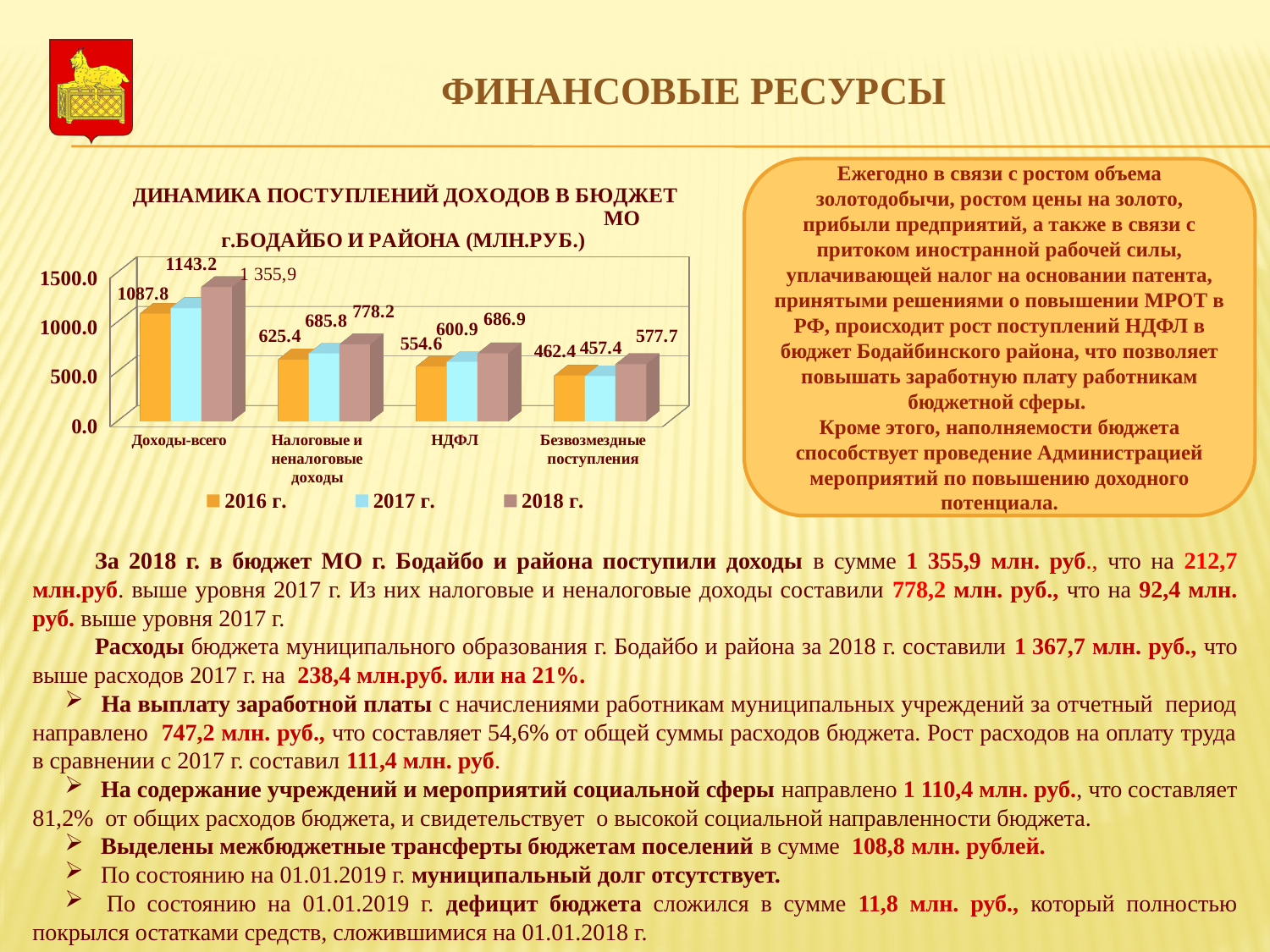
What is the difference between the 2018 г. and 2017 г. values for НДФЛ? 86.0 What kind of chart is shown on the slide? bar chart What is the value for 2018 г. in the Налоговые и неналоговые доходы category? 778.2 What is the value for 2017 г. in the Безвозмездные поступления category? 457.4 Which is larger for Безвозмездные поступления: the 2016 г. value or the 2017 г. value? 2016 г. Which category has the highest value for 2018 г.? Доходы-всего Is the 2017 г. value for Налоговые и неналоговые доходы greater or less than 500.0? greater How many categories are shown on the x axis of the chart? 4 Which category has the lowest value for 2016 г.? Безвозмездные поступления How many series does the chart legend list? 3 What is the value for 2018 г. in the Доходы-всего category? 1 355,9 What is the value for 2016 г. in the НДФЛ category? 554.6